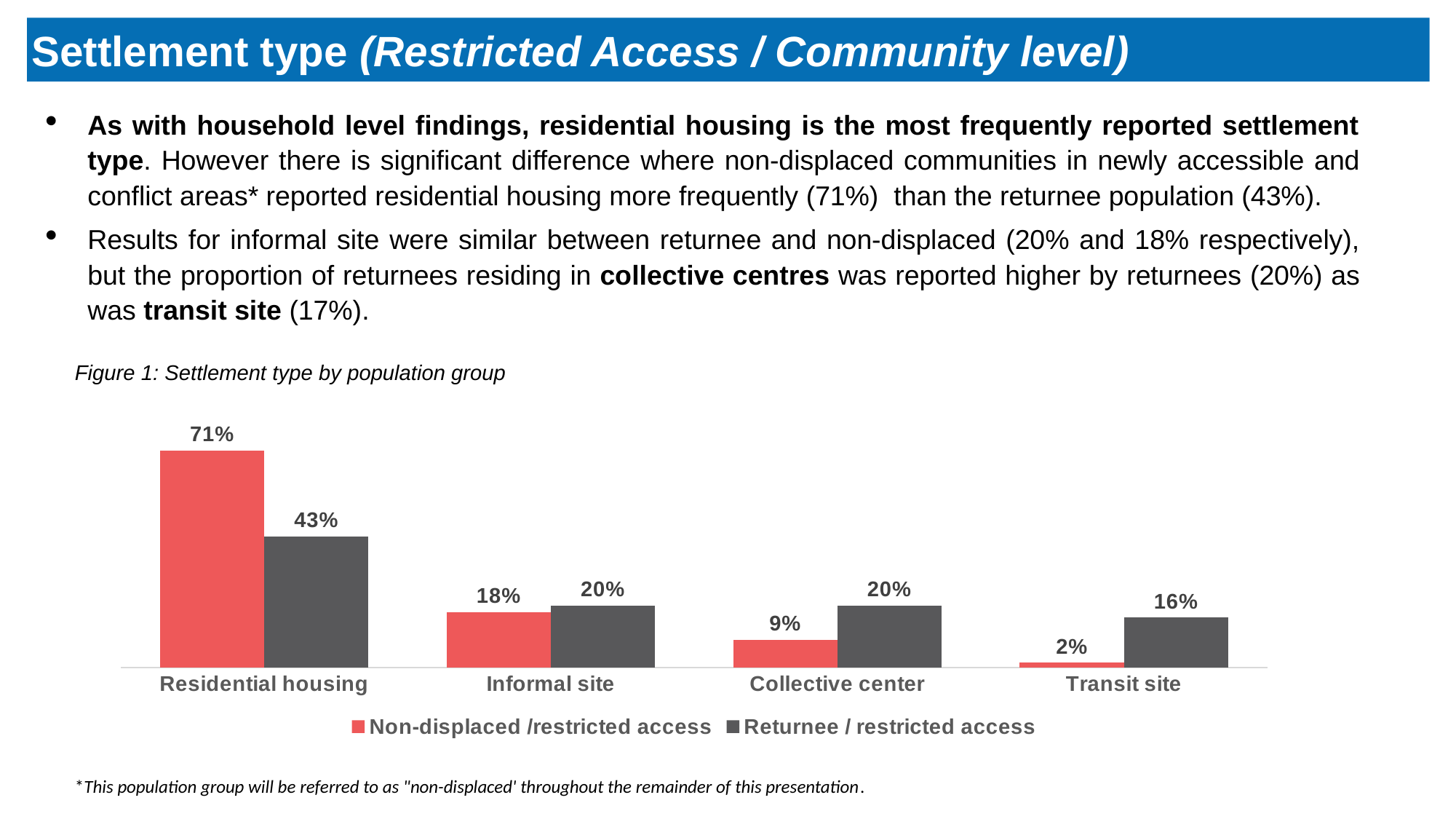
Which category has the lowest value in the Non-displaced /restricted access series? Transit site What kind of chart is shown on the slide? Bar chart What is the value for Transit site in the Returnee / restricted access series? 16% Which category has the highest value in the Returnee / restricted access series? Residential housing What is the value for Residential housing in the Non-displaced /restricted access series? 71% What is the difference between the Returnee / restricted access and Non-displaced /restricted access values for Transit site? 14% For Collective center, which series has the larger value: Non-displaced /restricted access or Returnee / restricted access? Returnee / restricted access What is the value for Collective center in the Non-displaced /restricted access series? 9% What is the difference between the Non-displaced /restricted access and Returnee / restricted access values for Residential housing? 28% What is the title of the figure shown on the slide? Figure 1: Settlement type by population group How many settlement type categories are shown on the x axis? 4 How many series does the legend list? 2